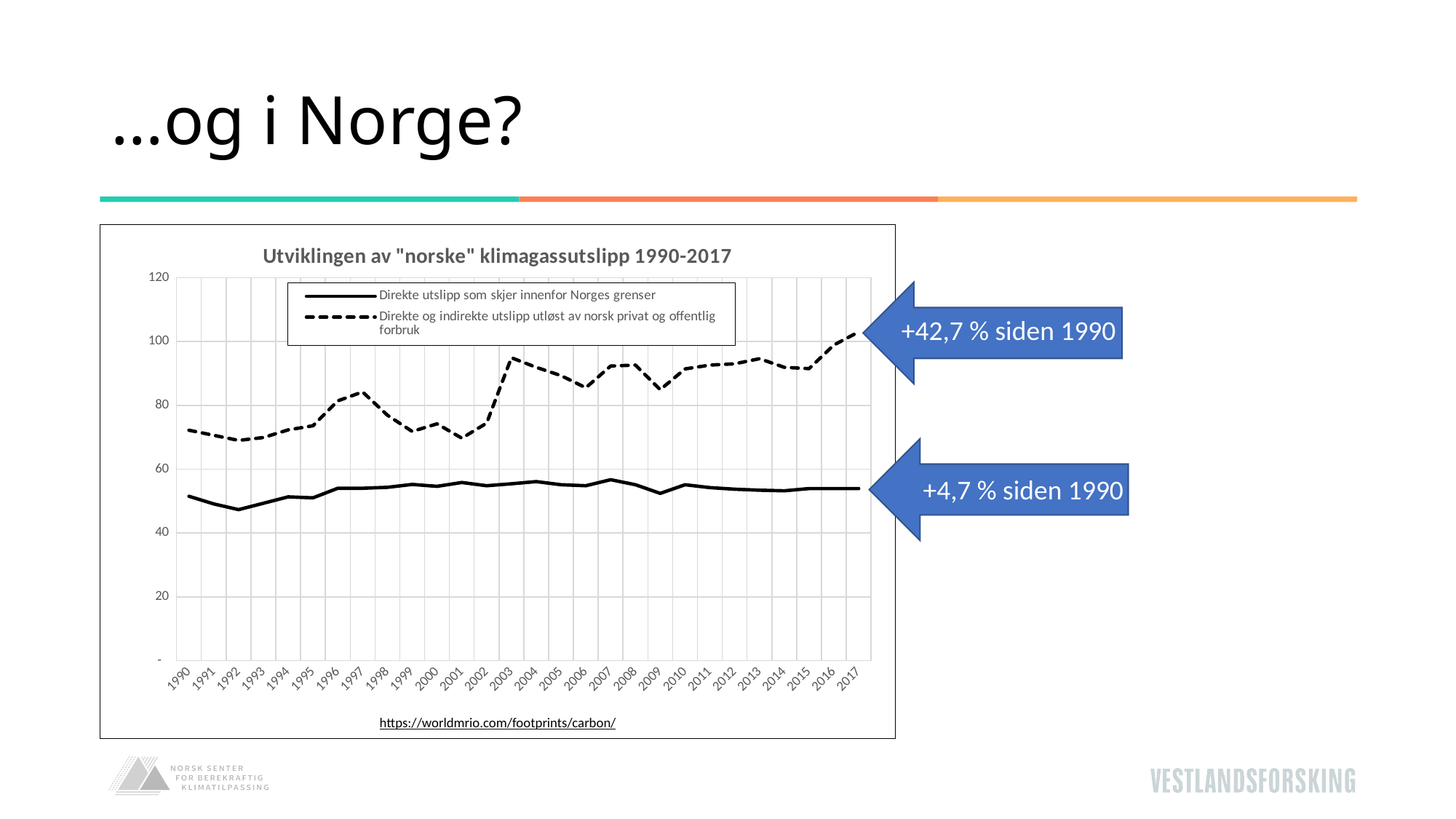
In which year is the dashed series (Direkte og indirekte utslipp) at its highest? 2017 How many years are plotted along the x axis? 28 In which year is the solid series (Direkte utslipp som skjer innenfor Norges grenser) at its lowest? 1992 Is the value of the dashed series in 2017 greater or less than 100? greater Does the dashed series rise or fall overall from 1990 to 2017? Rise Is the value of the dashed series in 1990 greater or less than 80? less Is the value of the solid series in 2017 greater or less than 60? less How many series does the legend list? 2 What kind of chart is shown on the slide? Line chart Which series is drawn with a dashed line? Direkte og indirekte utslipp utløst av norsk privat og offentlig forbruk In 2017, which series has the larger value: the solid line or the dashed line? The dashed line What is the title of the chart? Utviklingen av "norske" klimagassutslipp 1990-2017